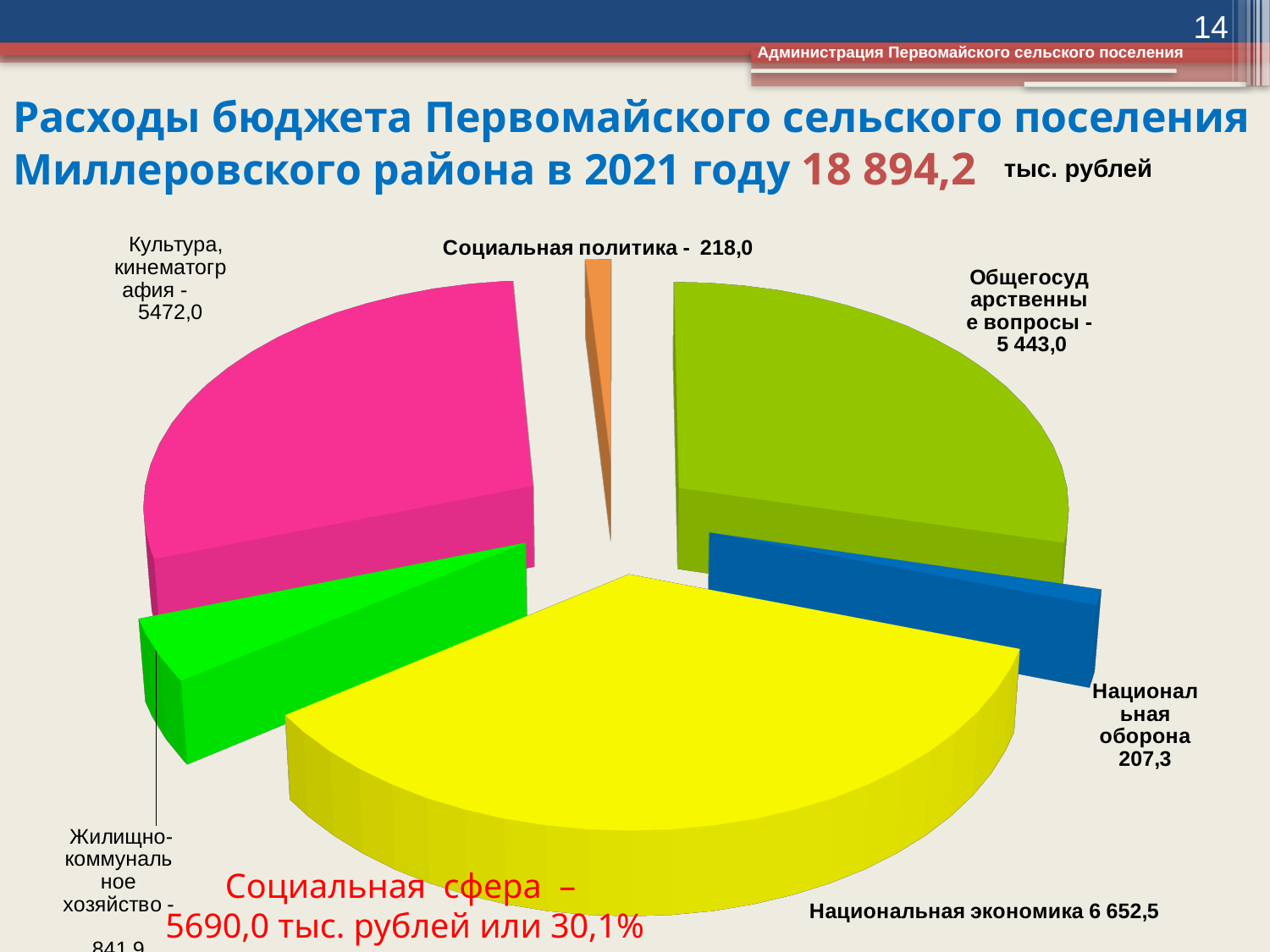
What is the value for Социальная политика? 218,0 What is the value for Национальная экономика? 6 652,5 What is the value for Общегосударственные вопросы? 5 443,0 What total budget expenditure figure is given in the slide title? 18 894,2 тыс. рублей How many slices does the pie chart have? 6 What is the value for Национальная оборона? 207,3 What is the difference between the values for Национальная экономика and Культура, кинематография? 1180,5 Which category has the smallest value? Национальная оборона Which category has the largest slice of the pie? Национальная экономика What kind of chart is shown on the slide? pie chart What is the value for Культура, кинематография? 5472,0 Which is larger, the value for Культура, кинематография or the value for Общегосударственные вопросы? Культура, кинематография